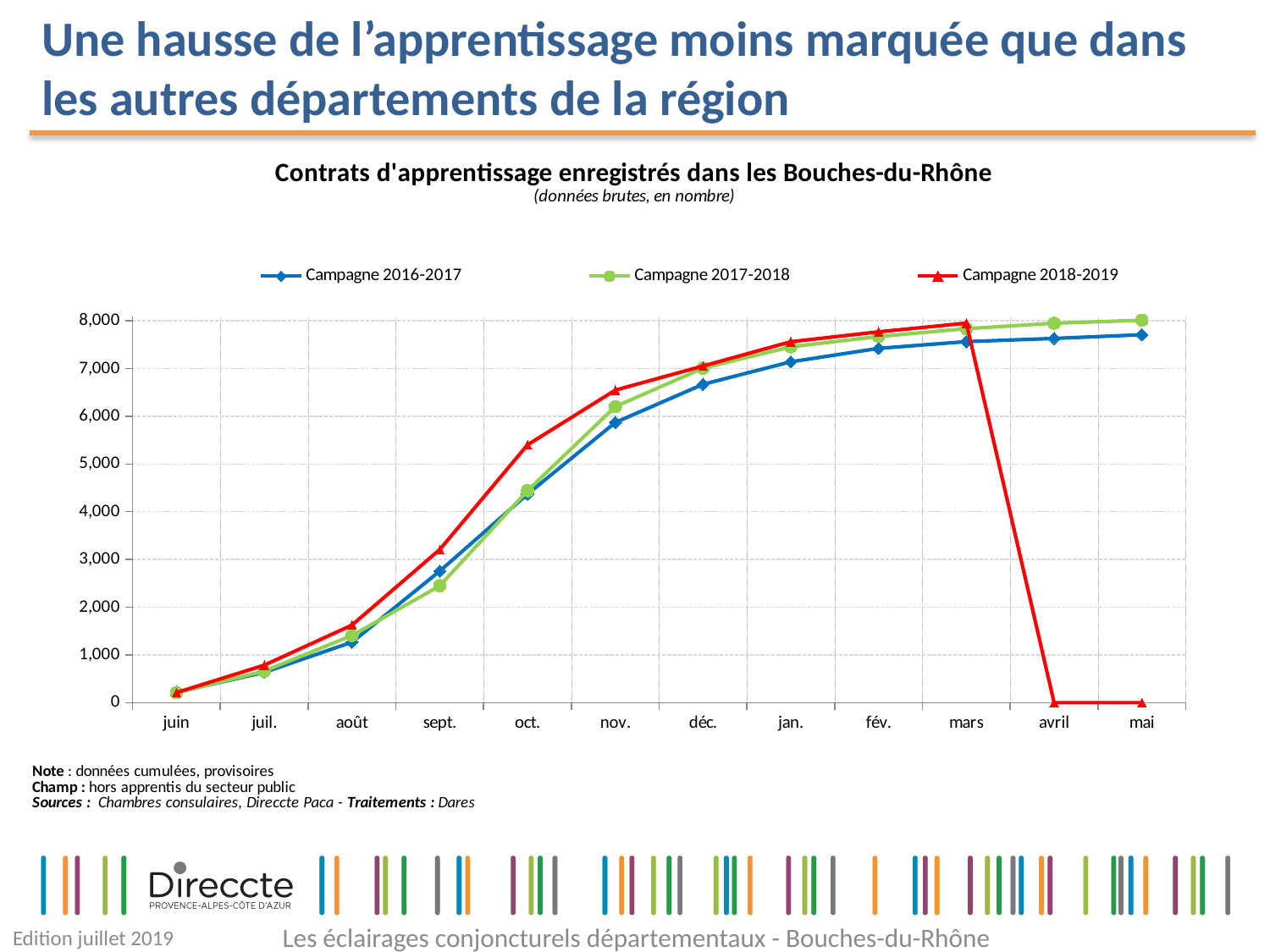
How many months are shown along the x axis? 12 In oct., which series has the larger value, Campagne 2018-2019 or Campagne 2016-2017? Campagne 2018-2019 Is the value for Campagne 2017-2018 in sept. greater or less than 2,000? greater What kind of chart is shown on the slide? line chart Is the value for Campagne 2016-2017 in nov. greater or less than 6,000? less Does the Campagne 2016-2017 series rise or fall from juin to mai? rise Which series is drawn in red? Campagne 2018-2019 How many series does the legend list? 3 In sept., which series has the larger value, Campagne 2016-2017 or Campagne 2017-2018? Campagne 2016-2017 Is the value for Campagne 2018-2019 in oct. greater or less than 5,000? greater What is the title of the chart? Contrats d'apprentissage enregistrés dans les Bouches-du-Rhône